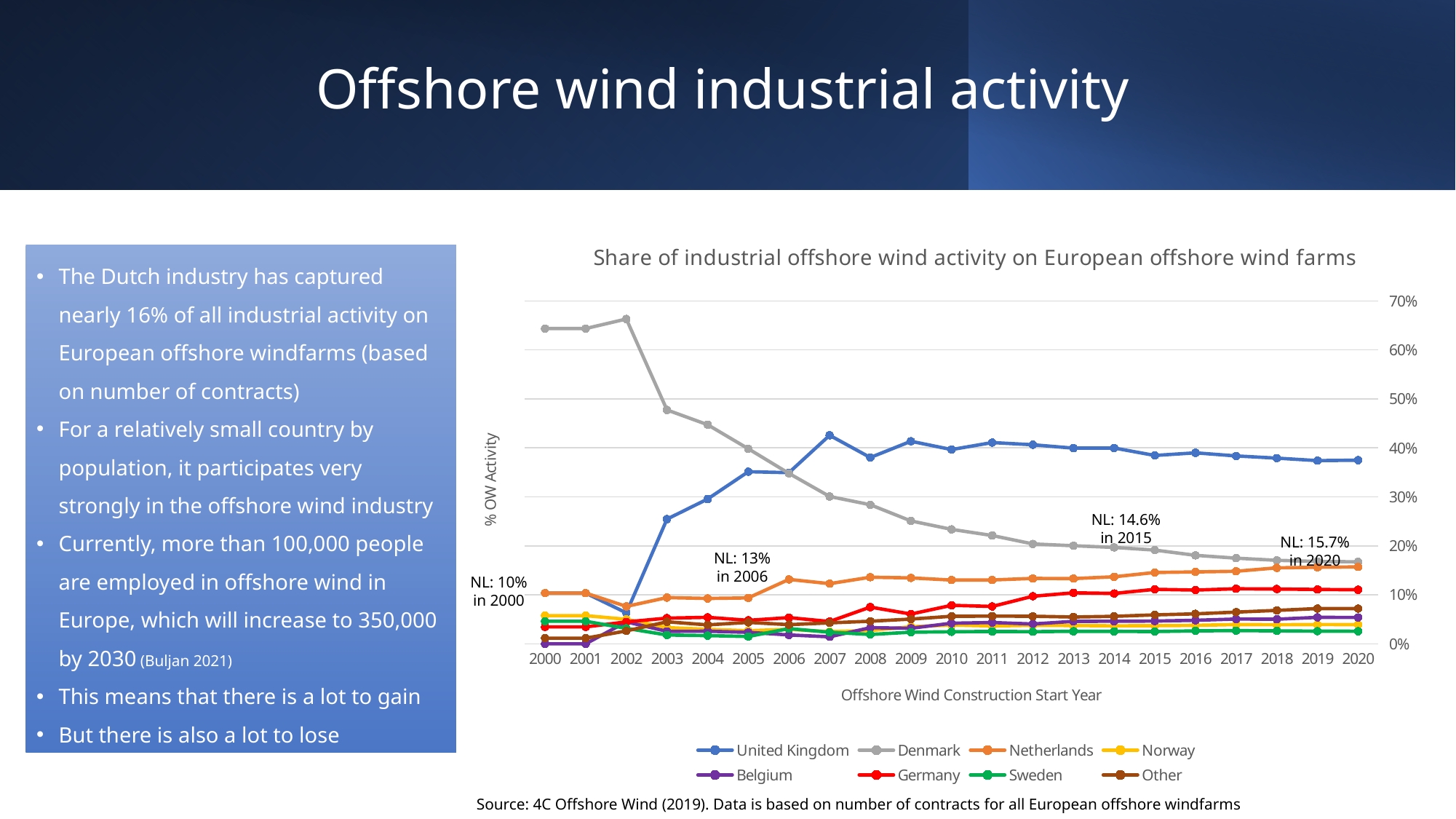
What was the Netherlands' share of industrial offshore wind activity in 2006? 13% How many series does the chart legend list? 8 Which country had the highest share of industrial offshore wind activity in 2000? Denmark What was the Netherlands' share of industrial offshore wind activity in 2020? 15.7% Does Denmark's share rise or fall from 2002 to 2020? Fall What was the Netherlands' share of industrial offshore wind activity in 2015? 14.6% Which country had the highest share of industrial offshore wind activity in 2020? United Kingdom What kind of chart is shown on the slide? Line chart What was the Netherlands' share of industrial offshore wind activity in 2000? 10% By how many percentage points did the Netherlands' share increase from 2000 to 2020? 5.7% Is the value for Denmark in 2000 greater or less than 60%? greater How many years are plotted along the x axis of the chart? 21